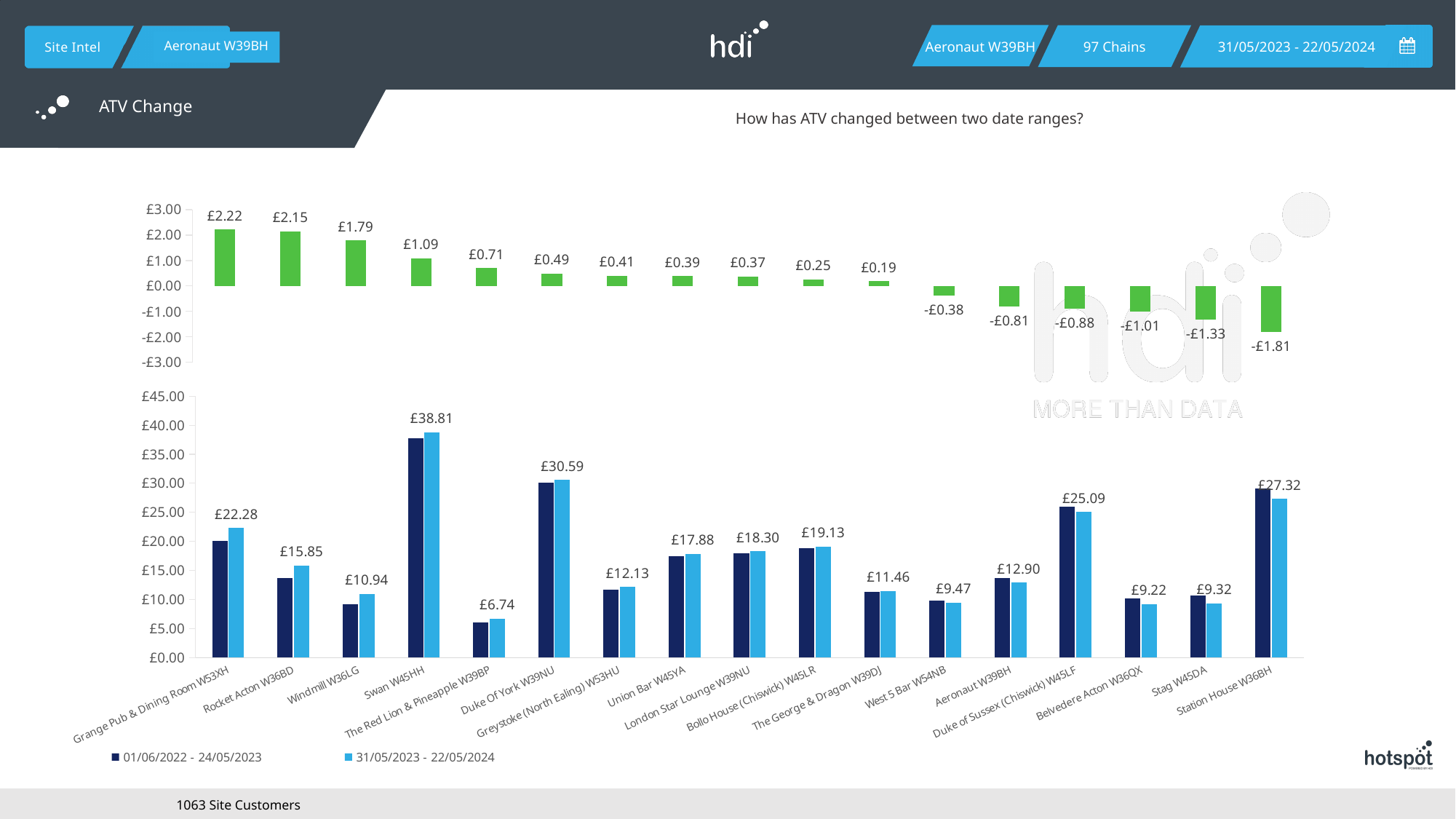
In the top chart, what is the lowest value shown? -£1.81 How many sites are shown on the x axis of the bottom chart? 17 In the bottom chart, what is the value for Swan W45HH in the 31/05/2023 - 22/05/2024 series? £38.81 In the bottom chart, which site has the lowest labelled value for 31/05/2023 - 22/05/2024? The Red Lion & Pineapple W39BP In the top chart, do the values rise or fall from left to right? fall In the bottom chart, is the 01/06/2022 - 24/05/2023 value for Station House W36BH greater or less than £25.00? greater In the bottom chart, what is the difference between the 31/05/2023 - 22/05/2024 values for Swan W45HH and Duke Of York W39NU? £8.22 How many series does the legend of the bottom chart list? 2 In the bottom chart, what is the value for Duke of Sussex (Chiswick) W45LF in the 31/05/2023 - 22/05/2024 series? £25.09 What kind of chart is the bottom chart? bar chart In the bottom chart, which site has the highest labelled value for 31/05/2023 - 22/05/2024? Swan W45HH In the top chart, what is the highest value shown? £2.22